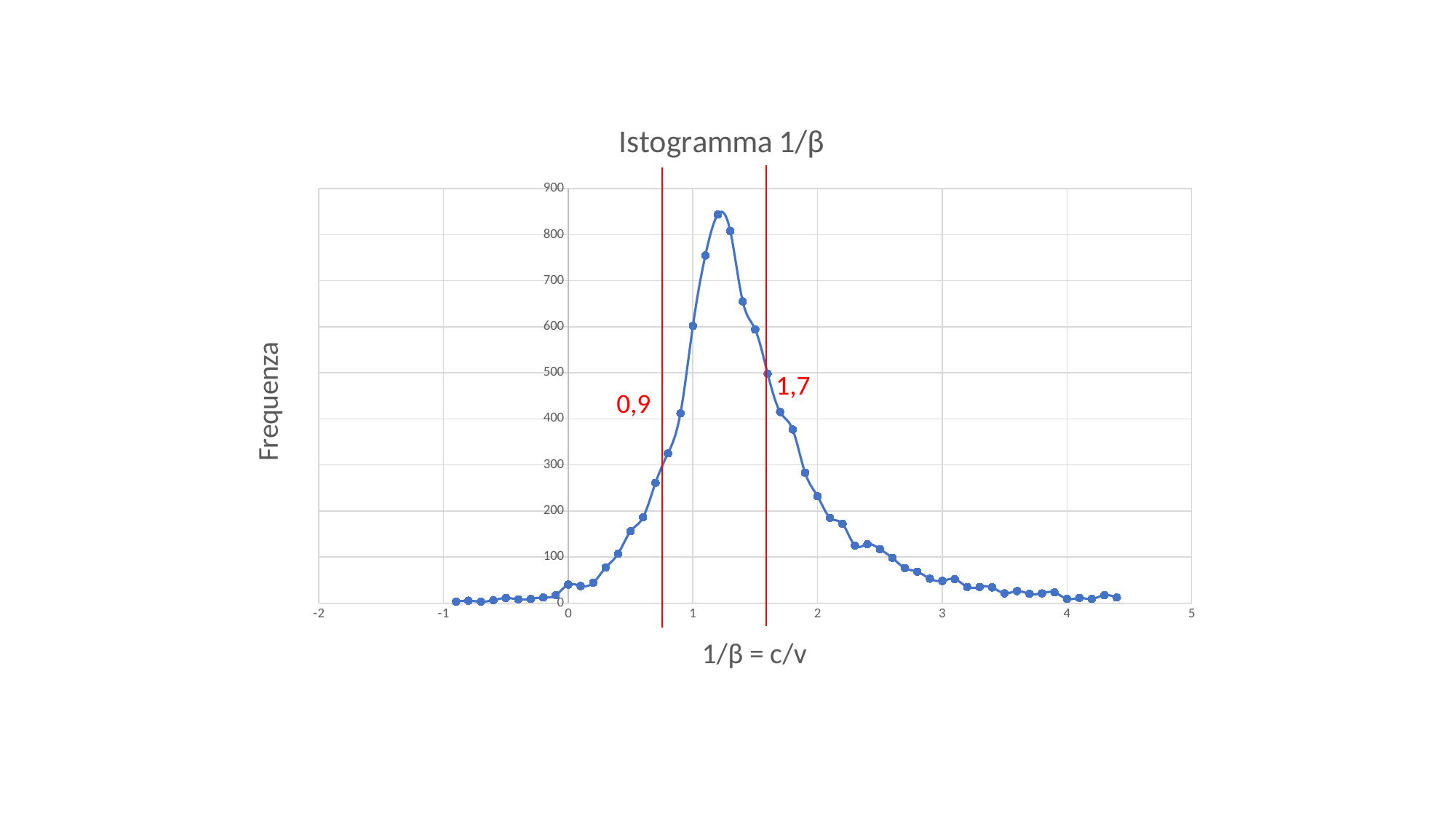
Is the value of the curve at x = 2 greater or less than 300? less Is the value of the curve at x = 1 greater or less than 500? greater Which is larger, the value of the curve at x = 1 or at x = 2? x = 1 Do the values rise or fall along the x axis between x = 2 and x = 4? fall Is the highest point of the curve greater or less than 800 on the Frequenza axis? greater What kind of chart is shown on the slide? line chart What values label the two red vertical lines on the chart? 0,9 and 1,7 What is the title of the chart? Istogramma 1/β Which is larger, the value of the curve at x = 1 or at x = 3? x = 1 Do the values rise or fall along the x axis between x = 0 and x = 1? rise